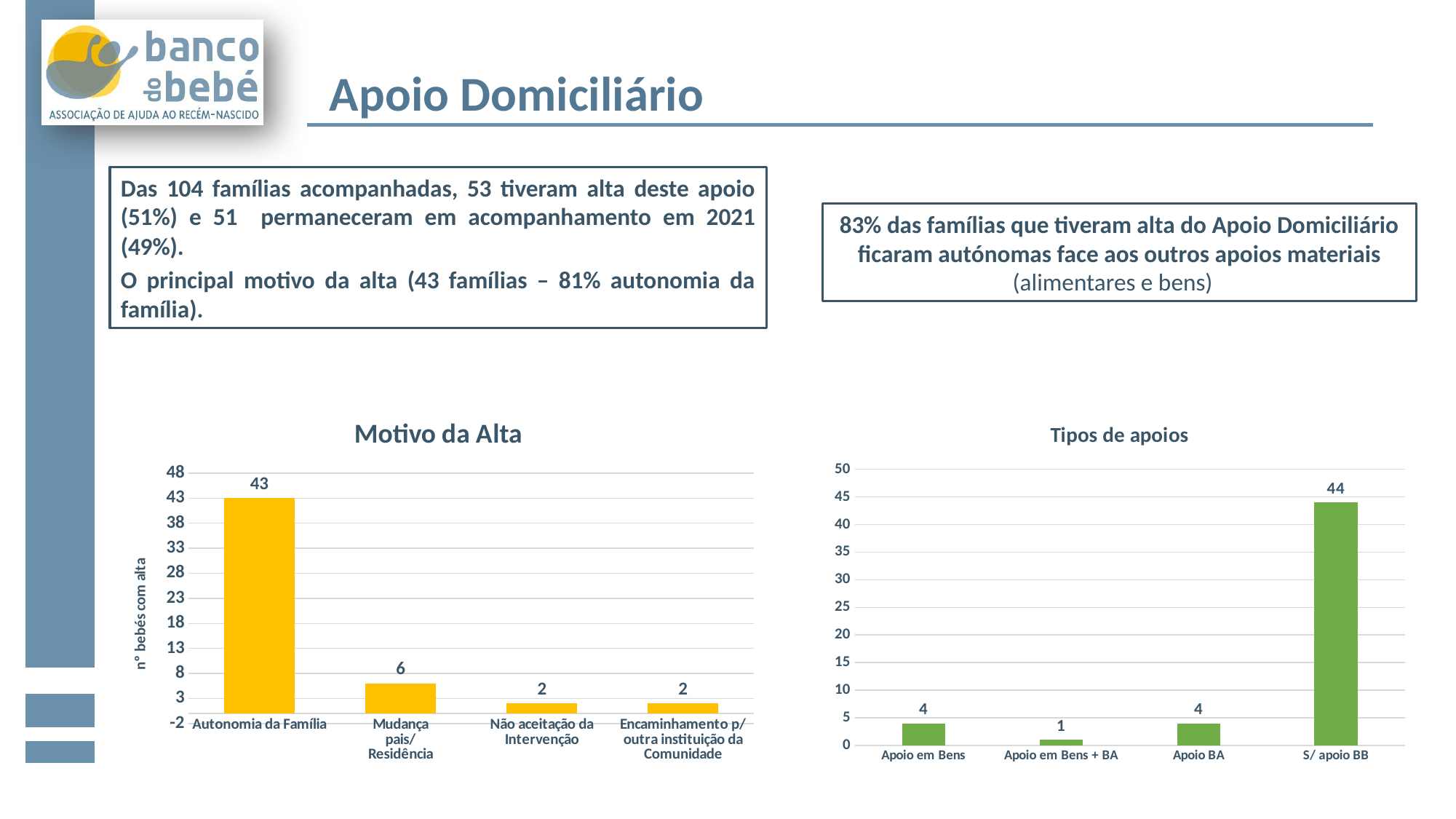
In the 'Tipos de apoios' chart, what is the value for Apoio em Bens + BA? 1 In the 'Motivo da Alta' chart, how many categories are shown? 4 What type of chart is 'Tipos de apoios'? Bar chart In the 'Tipos de apoios' chart, which category has the lowest value? Apoio em Bens + BA In the 'Tipos de apoios' chart, which is larger: Apoio BA or Apoio em Bens + BA? Apoio BA In the 'Motivo da Alta' chart, what is the value for Mudança pais/Residência? 6 In the 'Motivo da Alta' chart, which category has the highest value? Autonomia da Família In the 'Motivo da Alta' chart, what is the label of the vertical axis? nº bebés com alta In the 'Motivo da Alta' chart, what is the difference between Autonomia da Família and Mudança pais/Residência? 37 In the 'Motivo da Alta' chart, what is the value for Autonomia da Família? 43 In the 'Tipos de apoios' chart, what is the value for S/ apoio BB? 44 In the 'Tipos de apoios' chart, what is the difference between S/ apoio BB and Apoio em Bens? 40